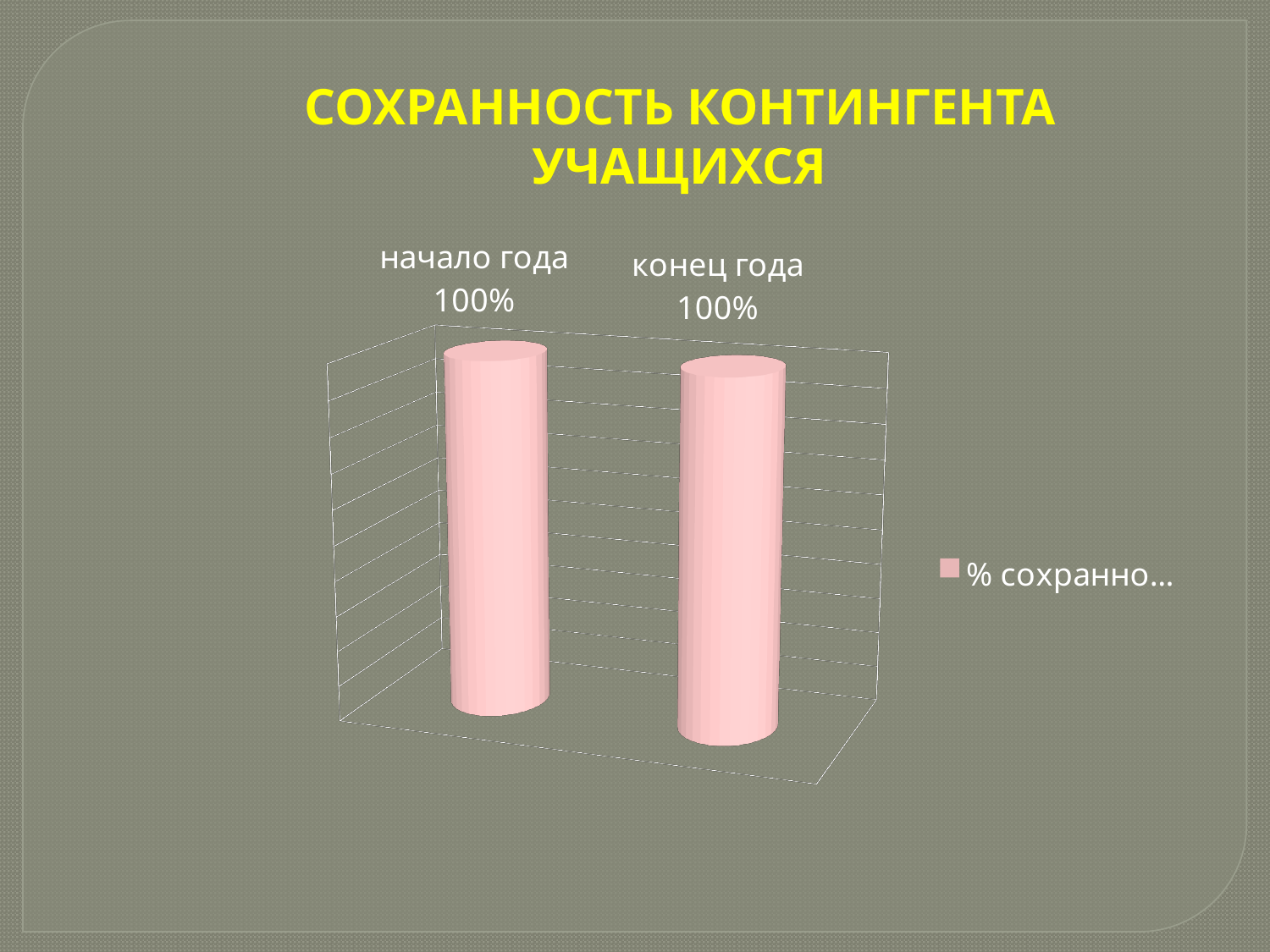
What is the value for конец года? 100% What is the title of the slide? СОХРАННОСТЬ КОНТИНГЕНТА УЧАЩИХСЯ What kind of chart is shown on the slide? Bar chart Which category is shown first (leftmost) on the chart? начало года How many categories are shown on the chart? 2 What colour are the bars on the chart? Pink What is the value for начало года? 100% What is the difference between the values for начало года and конец года? 0% Do the values rise, fall or stay the same from начало года to конец года? Stay the same How many series does the legend list? 1